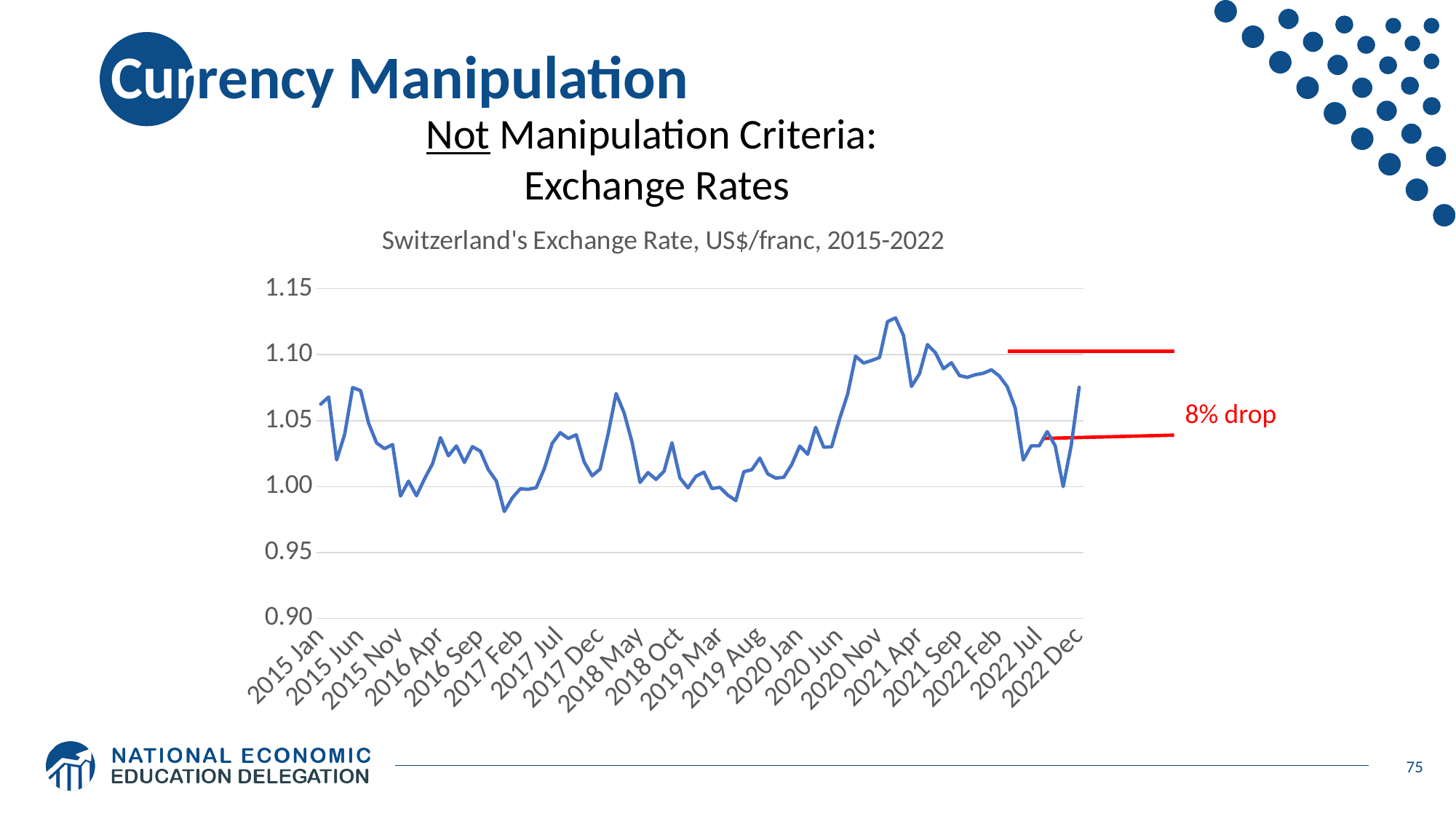
Is the value for 2022 Jul greater or less than 1.05? less Does the exchange rate rise or fall between 2022 Feb and 2022 Jul? fall Is the value for 2016 Sep greater or less than 1.00? greater In which year does the line reach its highest value? 2021 Does the exchange rate rise or fall between 2020 Jun and 2020 Nov? rise Is the highest point on the line greater or less than 1.10? greater What kind of chart is shown on the slide? line chart What annotation is written in red next to the chart? 8% drop What is the title of the chart? Switzerland's Exchange Rate, US$/franc, 2015-2022